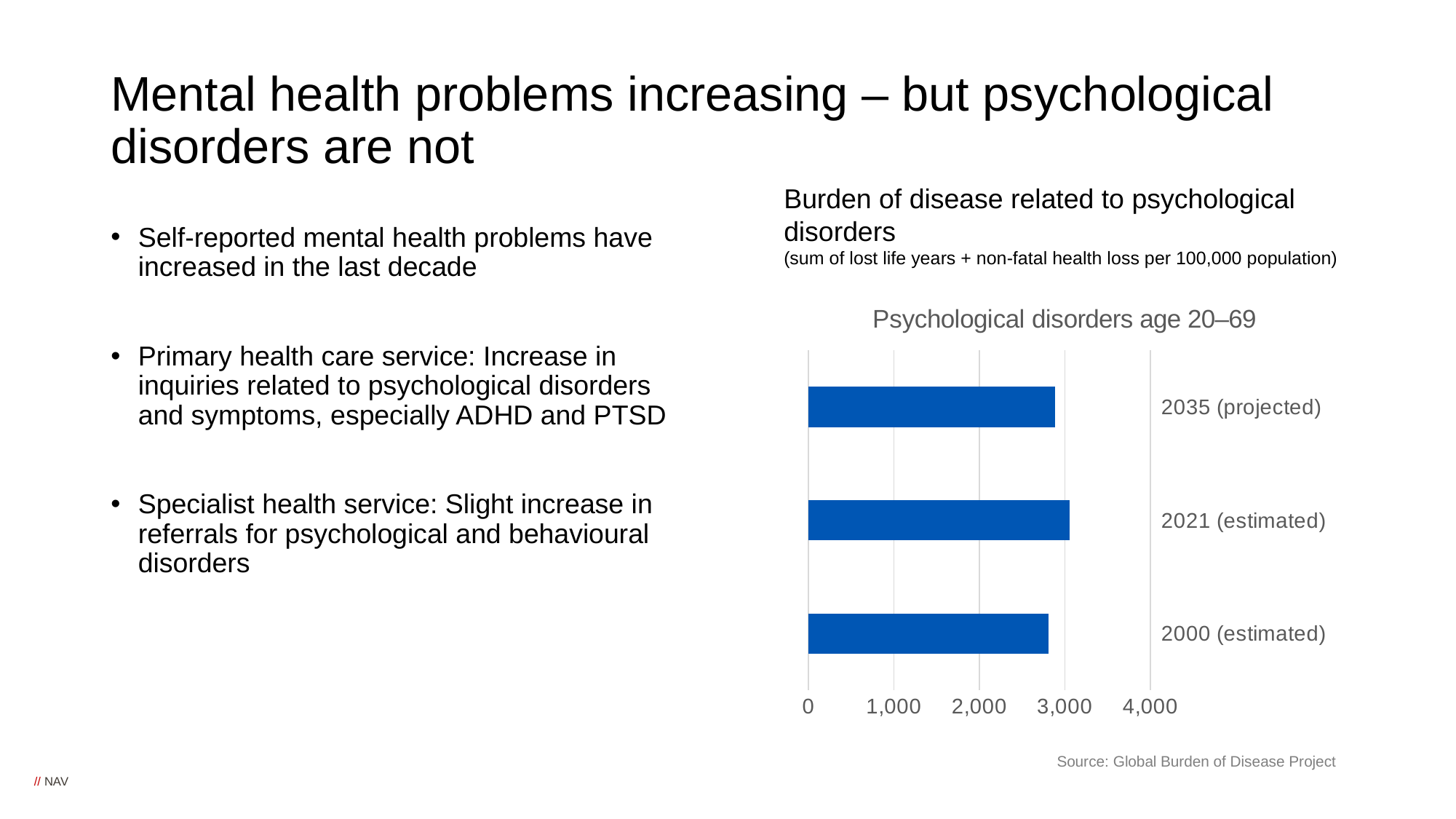
Which is larger: the value for 2021 (estimated) or the value for 2000 (estimated)? 2021 (estimated) Is the value for 2000 (estimated) greater or less than 3,000? less Is the value for 2035 (projected) greater or less than 2,000? greater Is the value for 2000 (estimated) greater or less than 2,000? greater What is the title shown directly above the bars of the chart? Psychological disorders age 20–69 What kind of chart is shown on the slide? bar chart How many categories (bars) does the chart show? 3 What is the highest tick value shown on the chart's horizontal axis? 4,000 Which category has the highest value in the chart? 2021 (estimated)